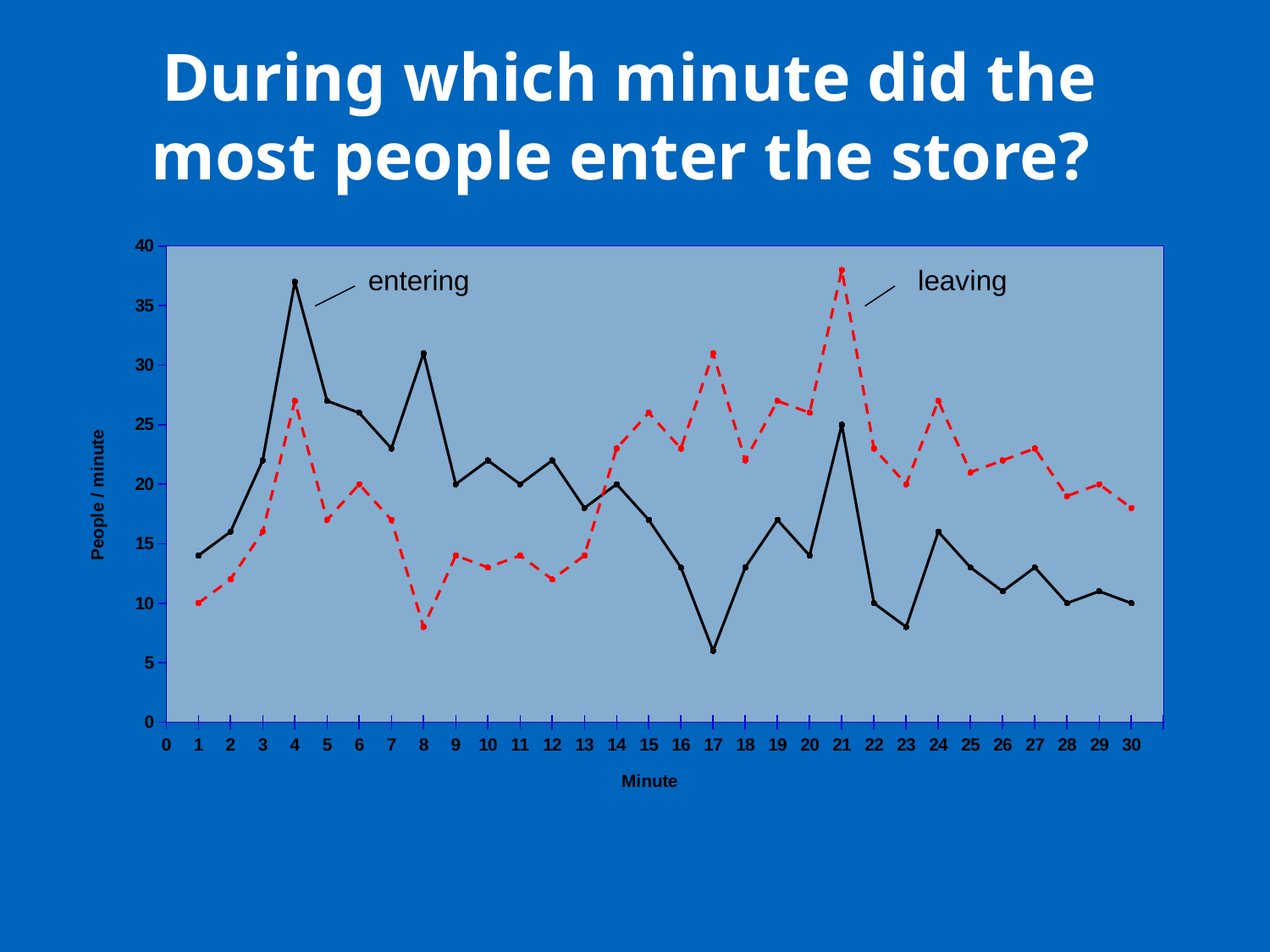
What kind of chart is shown on the slide? line chart Is the leaving value at minute 8 greater or less than 10? less Is the entering value at minute 4 greater or less than 35? greater At minute 21, which series has the larger value, entering or leaving? leaving During which minute is the entering series at its highest? 4 How many series are plotted on the chart? 2 During which minute is the leaving series at its lowest? 8 During which minute is the entering series at its lowest? 17 At minute 4, which series has the larger value, entering or leaving? entering What is the label of the y axis? People / minute During which minute is the leaving series at its highest? 21 What are the two series labelled on the chart? entering and leaving